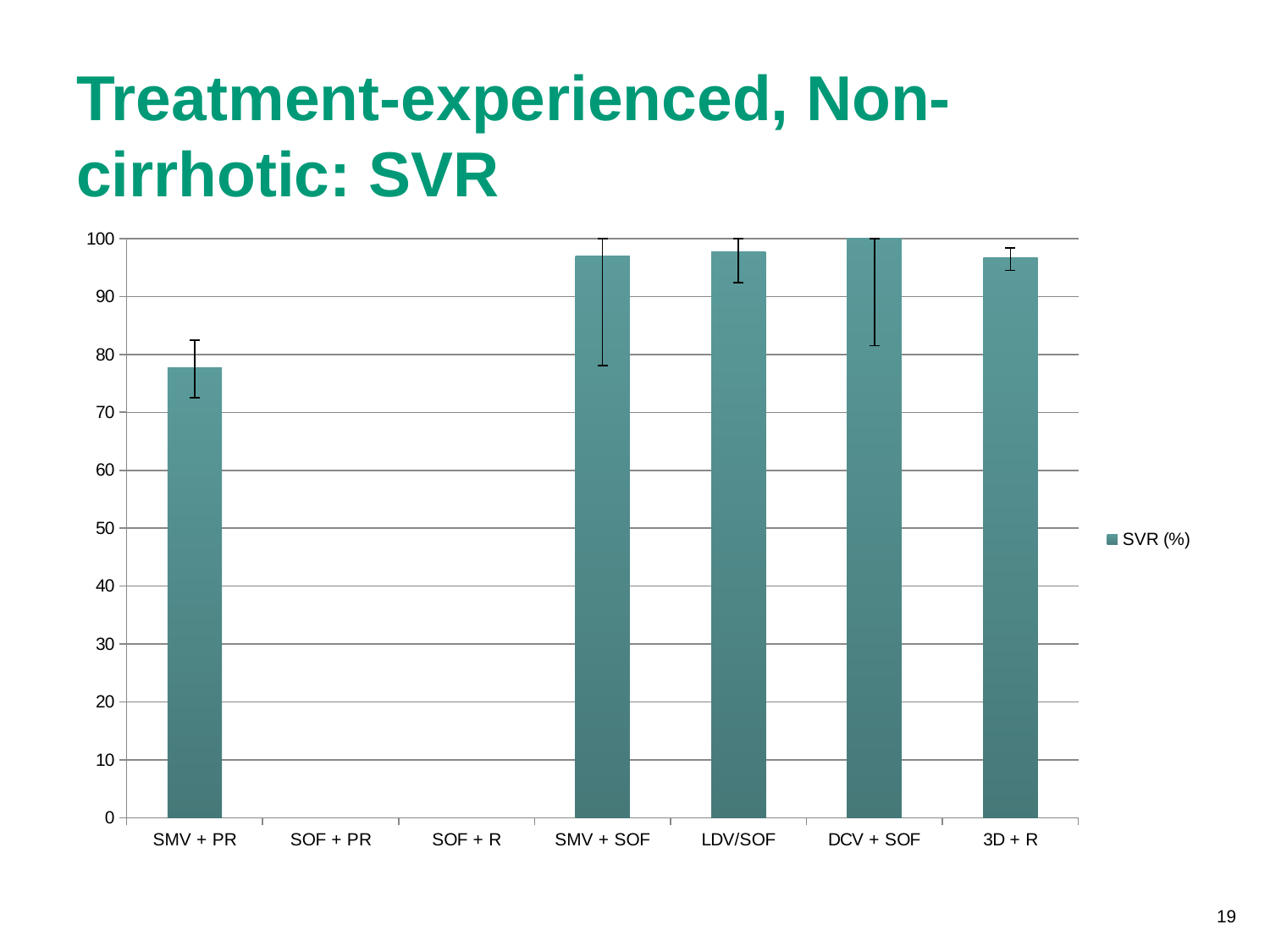
What is the SVR (%) value for DCV + SOF? 100 What is the title of the slide containing the chart? Treatment-experienced, Non-cirrhotic: SVR Which category has the highest SVR (%) bar? DCV + SOF Which has a larger SVR (%) value, SMV + PR or SMV + SOF? SMV + SOF How many series does the chart legend list? 1 What kind of chart is shown on the slide? Bar chart Is the SVR (%) value for SMV + PR greater or less than 80? less What is the series name shown in the chart legend? SVR (%) Is the SVR (%) value for SMV + SOF greater or less than 90? greater Is the SVR (%) value for 3D + R greater or less than 90? greater How many categories are shown on the x axis of the chart? 7 Among the categories with a plotted bar, which has the lowest SVR (%)? SMV + PR